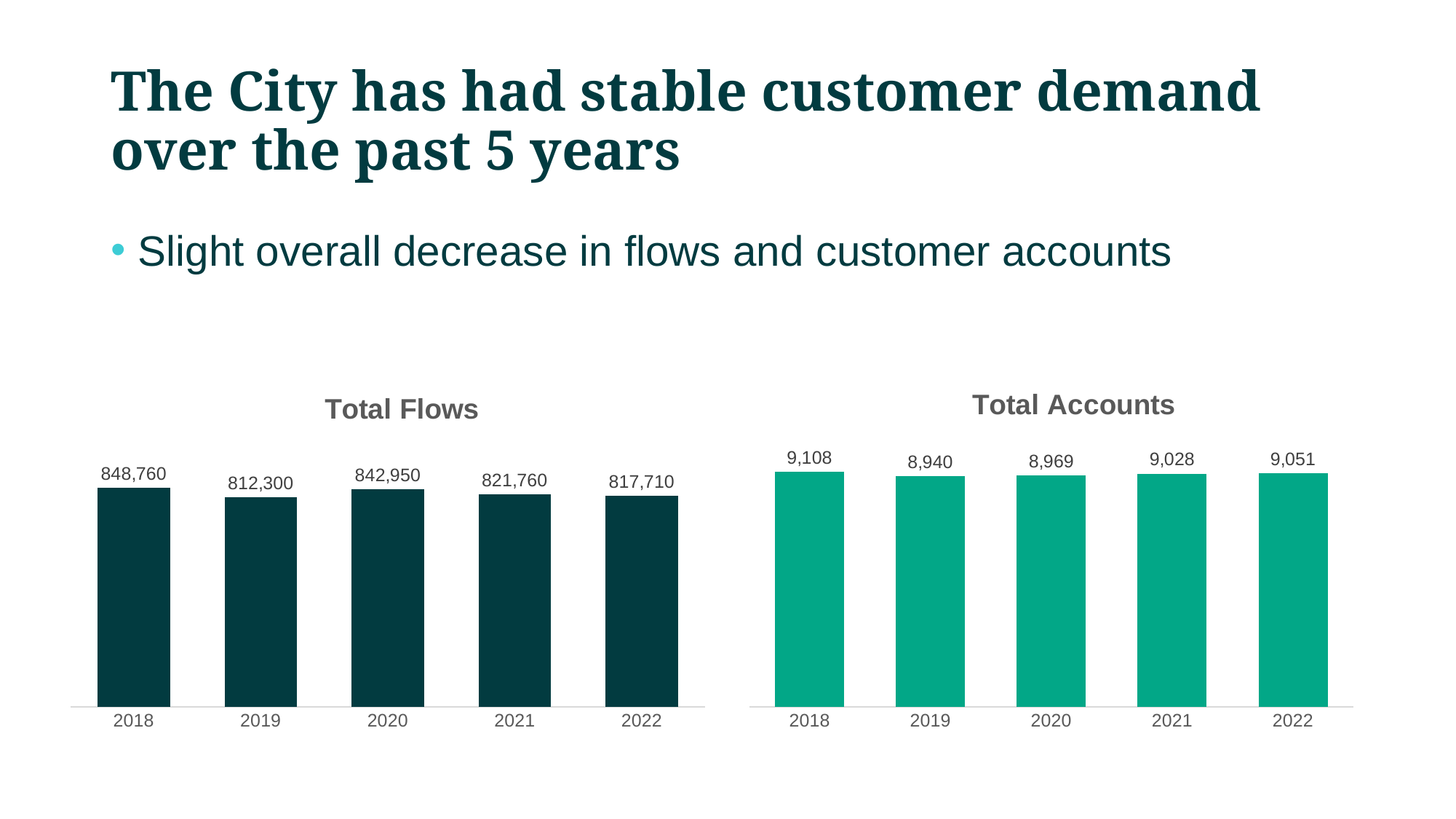
In the Total Accounts chart, what is the value for 2022? 9,051 In the Total Flows chart, which year has the lowest value? 2019 In the Total Accounts chart, what is the difference between the 2021 and 2019 values? 88 What kind of chart is the Total Flows chart? Bar chart In the Total Accounts chart, which year has the highest value? 2018 What is the title of the chart on the right side of the slide? Total Accounts How many years are shown in the Total Accounts chart? 5 In the Total Flows chart, what is the value for 2018? 848,760 In the Total Accounts chart, what is the value for 2019? 8,940 In the Total Flows chart, what is the difference between the 2018 and 2022 values? 31,050 In the Total Flows chart, what is the value for 2021? 821,760 In the Total Flows chart, which is larger, the value for 2020 or the value for 2021? 2020